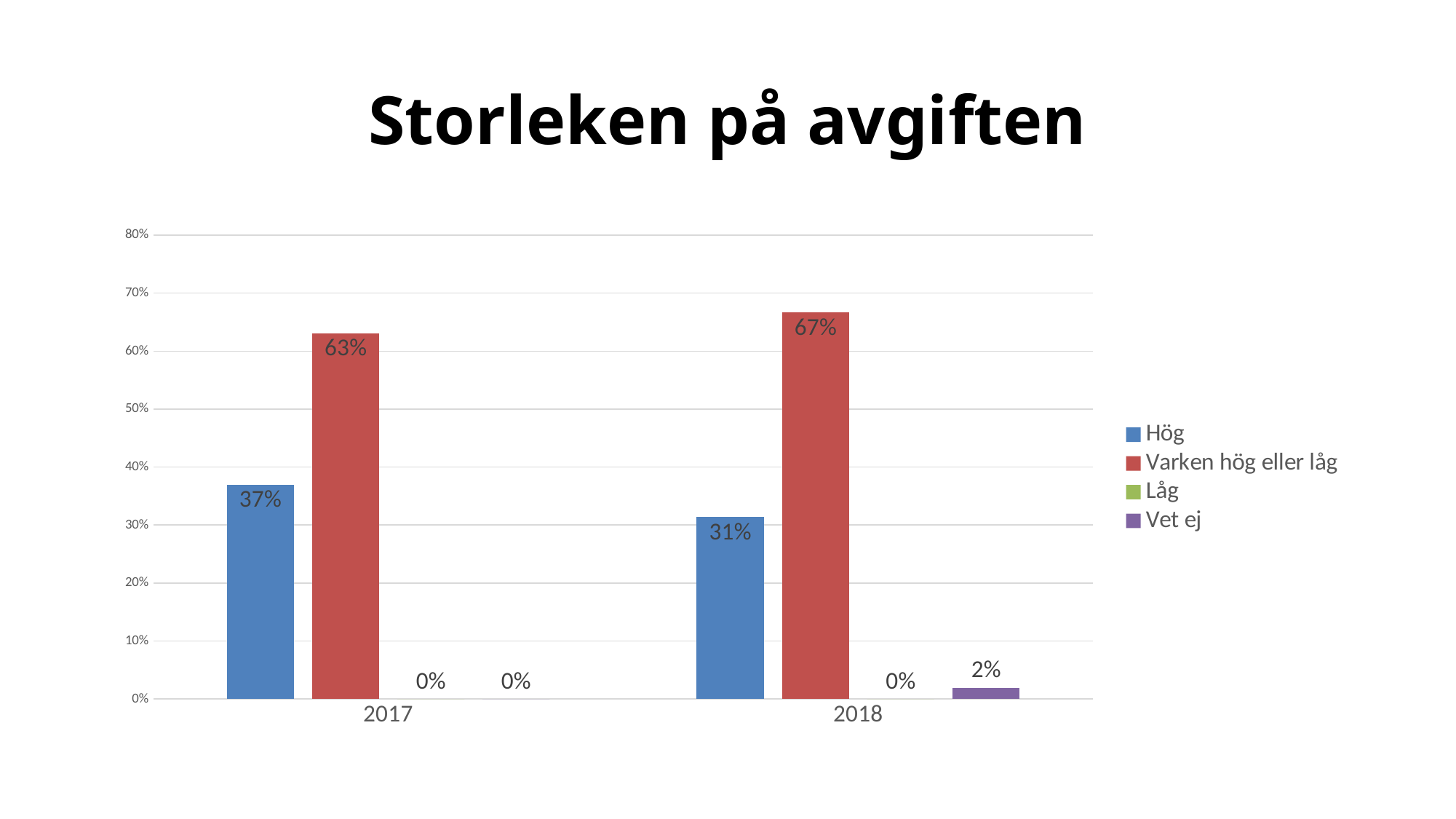
Which is larger: Hög in 2017 or Hög in 2018? Hög in 2017 What is the value for Hög in 2017? 37% Is the value for Varken hög eller låg in 2018 greater or less than 60%? greater What is the value for Låg in 2017? 0% How many years are shown on the x axis? 2 How many series does the legend list? 4 What is the difference between Varken hög eller låg and Hög in 2017? 26% Which series has the highest value in 2018? Varken hög eller låg What is the title of the chart? Storleken på avgiften What is the value for Varken hög eller låg in 2018? 67% What is the value for Vet ej in 2018? 2% What kind of chart is shown? Bar chart